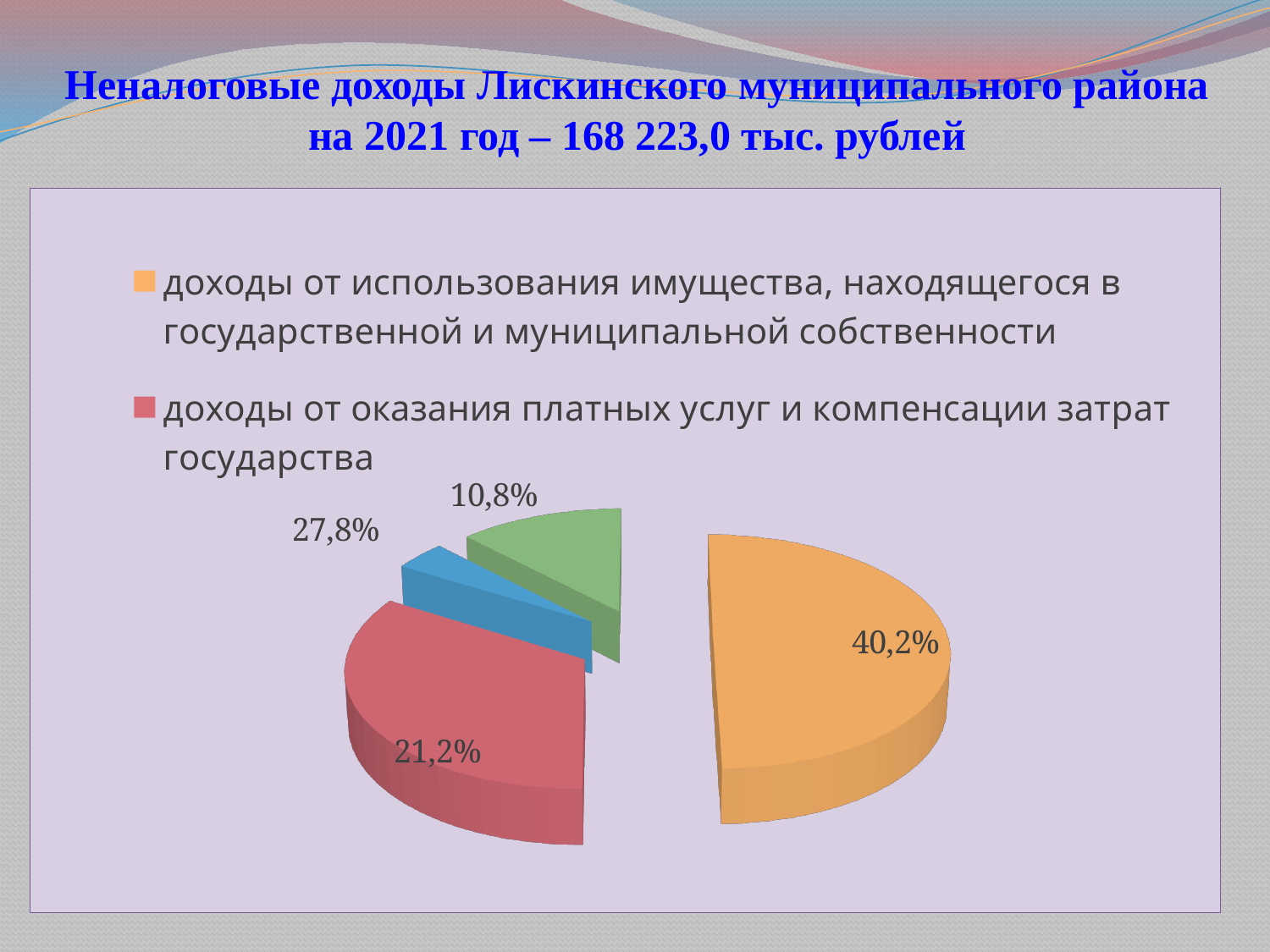
Which is larger: the slice for доходы от использования имущества or the slice for доходы от оказания платных услуг и компенсации затрат государства? доходы от использования имущества What is the largest percentage labelled on the pie chart? 40,2% Which legend category has the largest slice of the pie? доходы от использования имущества, находящегося в государственной и муниципальной собственности According to the slide title, what is the total of non-tax revenues of Лискинский муниципальный район for 2021? 168 223,0 тыс. рублей What share of the pie is labelled for доходы от оказания платных услуг и компенсации затрат государства? 21,2% What share of the pie is labelled for доходы от использования имущества, находящегося в государственной и муниципальной собственности? 40,2% What do the four percentage labels on the pie chart add up to? 100% What type of chart is shown on the slide? pie chart How many slices does the pie chart have? 4 What colour is the slice for доходы от использования имущества, находящегося в государственной и муниципальной собственности? orange What is the smallest percentage labelled on the pie chart? 10,8% By how many percentage points does the slice for доходы от использования имущества exceed the slice for доходы от оказания платных услуг? 19,0 percentage points